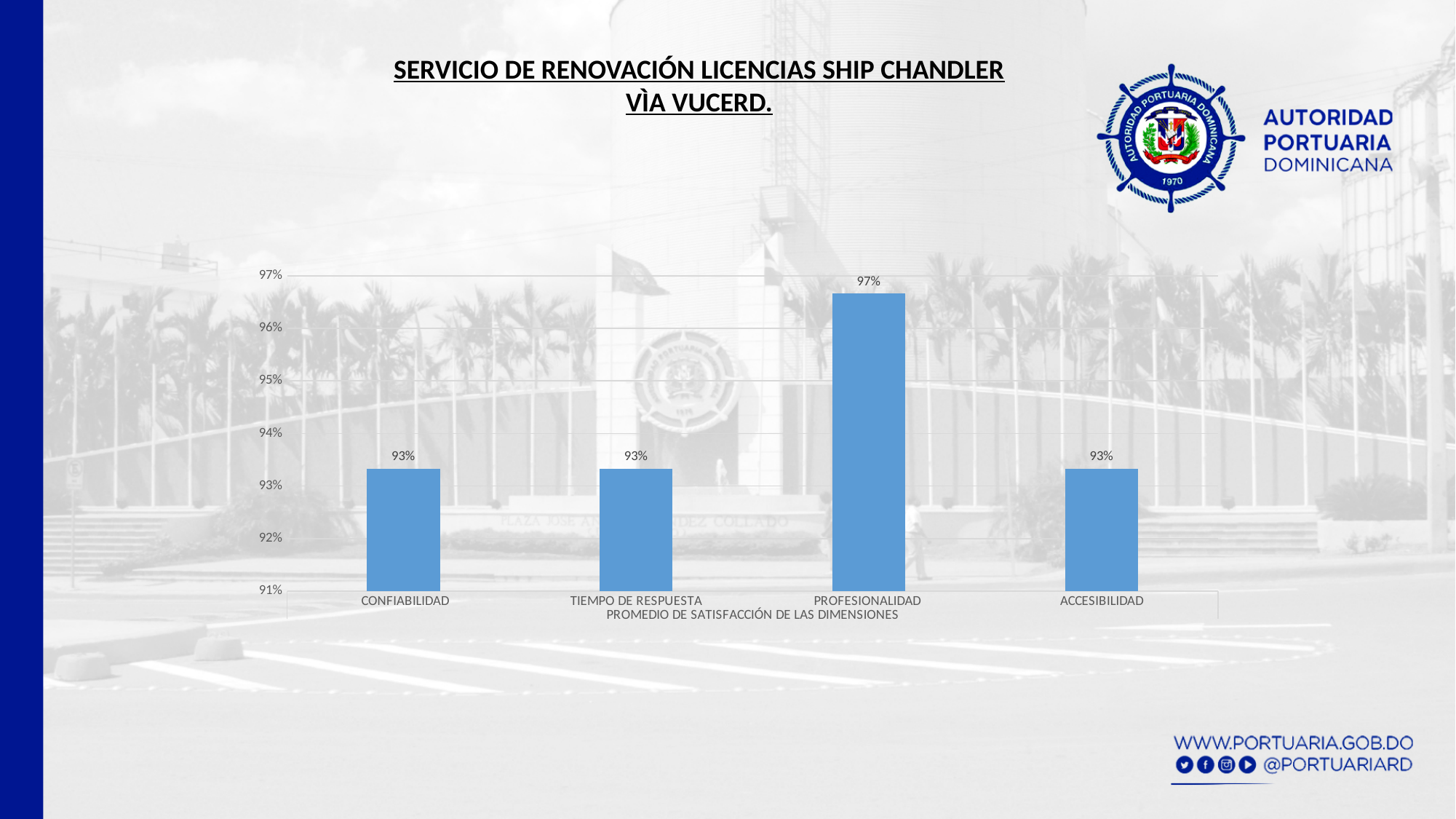
Which is larger, the value for PROFESIONALIDAD or the value for CONFIABILIDAD? PROFESIONALIDAD Which category has the highest value? PROFESIONALIDAD What is the value for TIEMPO DE RESPUESTA? 93% What is the label shown under the category names on the x axis? PROMEDIO DE SATISFACCIÓN DE LAS DIMENSIONES How many categories are shown on the x axis? 4 What is the value for ACCESIBILIDAD? 93% Is the value for PROFESIONALIDAD greater or less than 95%? greater What kind of chart is shown on the slide? Bar chart Is the value for TIEMPO DE RESPUESTA greater or less than 95%? less What is the difference between the values for PROFESIONALIDAD and ACCESIBILIDAD? 4 percentage points What is the value for CONFIABILIDAD? 93% What is the value for PROFESIONALIDAD? 97%